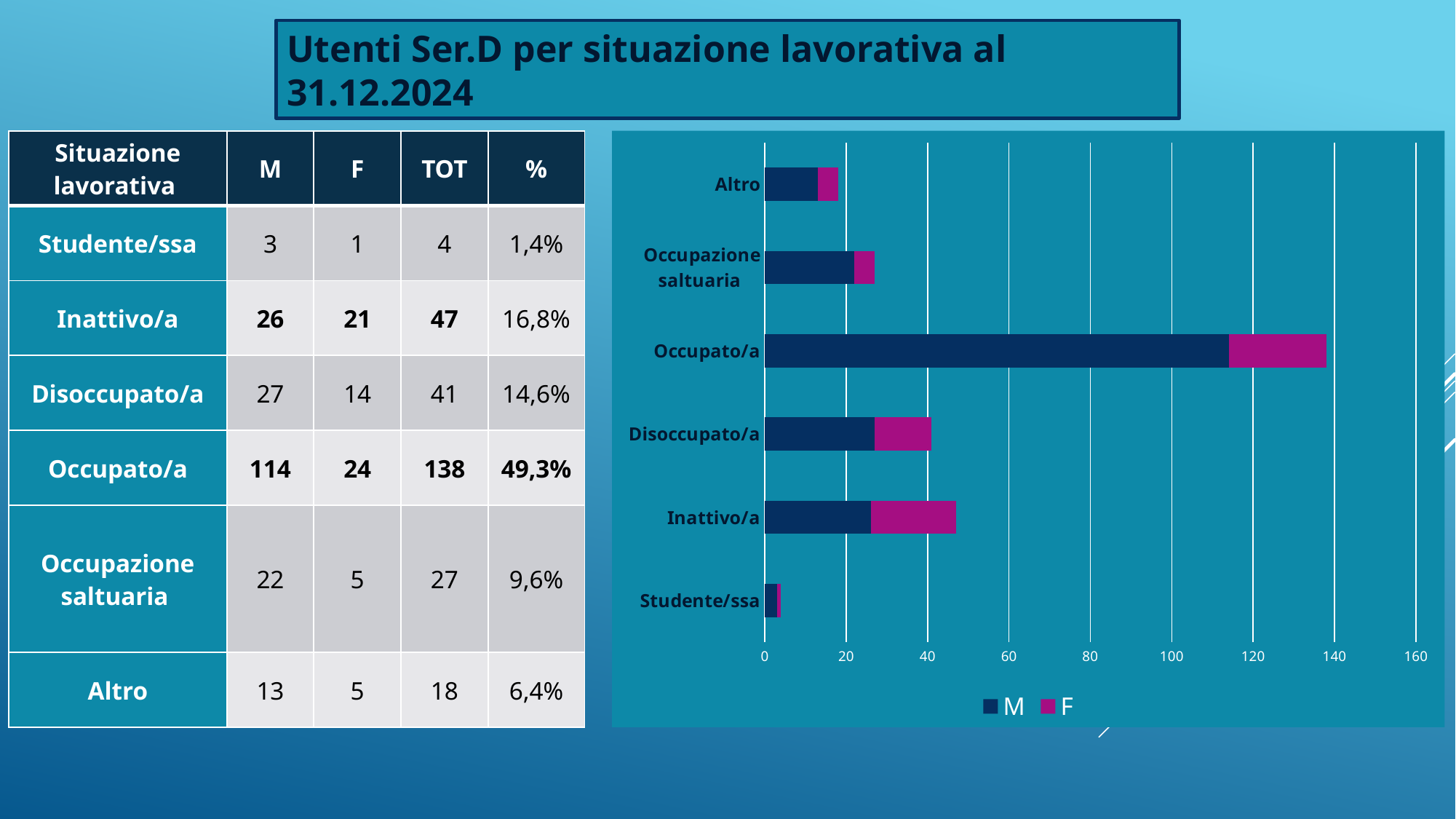
Which is larger, the total bar for Inattivo/a or for Disoccupato/a? Inattivo/a How many categories are plotted on the chart? 6 What is the M value for Occupato/a? 114 Is the total bar for Occupato/a greater or less than 120? greater Which category has the longest bar in the chart? Occupato/a What is the difference between the M values for Disoccupato/a and Inattivo/a? 1 How many series does the chart legend list? 2 Which category has the shortest bar in the chart? Studente/ssa Which series is shown in magenta in the chart legend? F What kind of chart is shown on the slide? stacked bar chart What is the total of the stacked bar for Disoccupato/a? 41 What is the F value for Inattivo/a? 21